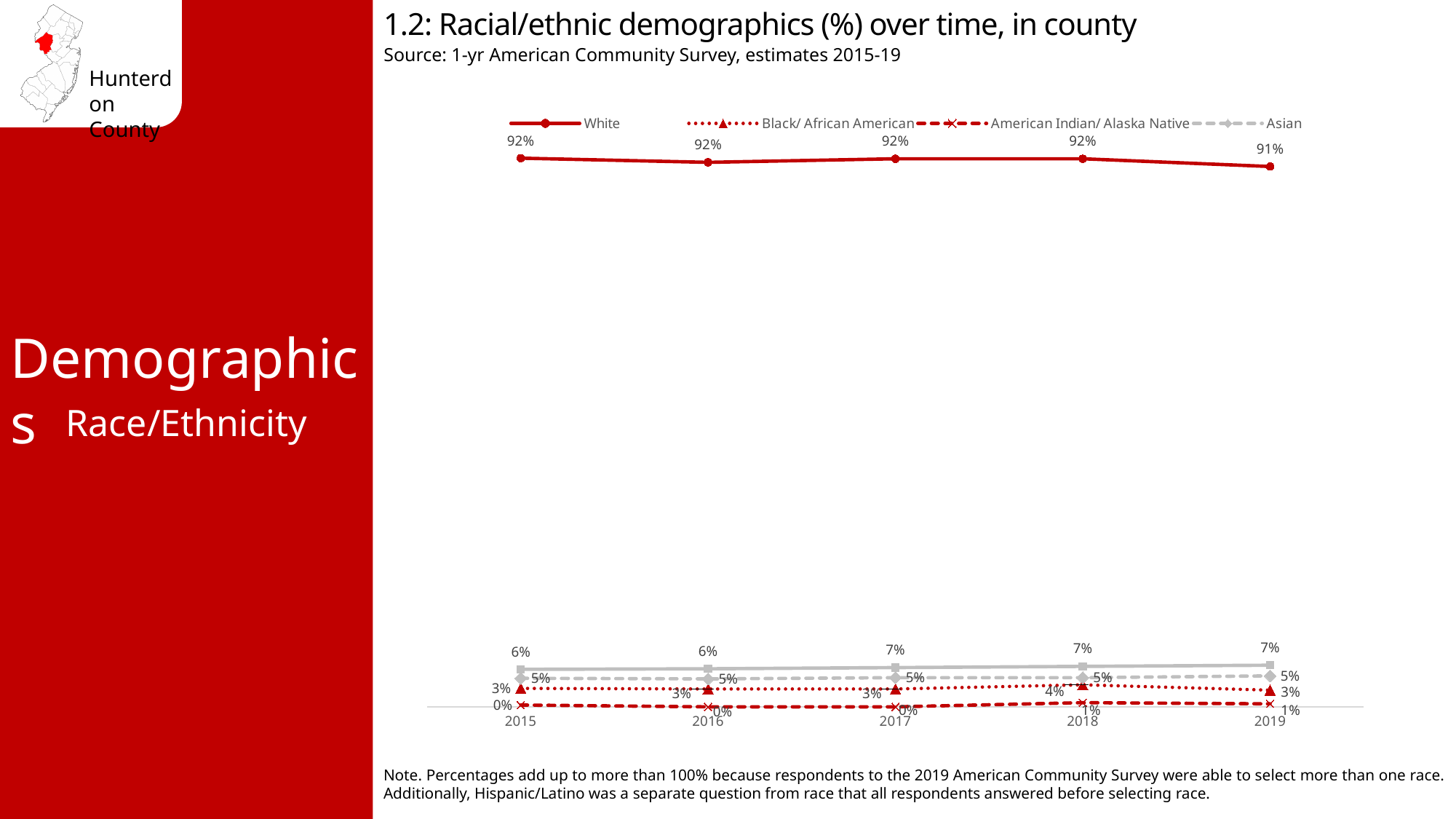
What is the title of the chart? 1.2: Racial/ethnic demographics (%) over time, in county What is the value for White in 2015? 92% What is the value for Asian in 2017? 5% In 2016, which is larger: the Asian value or the Black/ African American value? Asian How many years are plotted along the x axis? 5 What is the value for Black/ African American in 2018? 4% What is the difference between the White value in 2015 and in 2019? 1 percentage point What is the value for American Indian/ Alaska Native in 2015? 0% Which series has the highest value in 2019? White What is the value for White in 2019? 91% What kind of chart is shown on the slide? Line chart Does the American Indian/ Alaska Native series rise or fall from 2015 to 2019? Rises